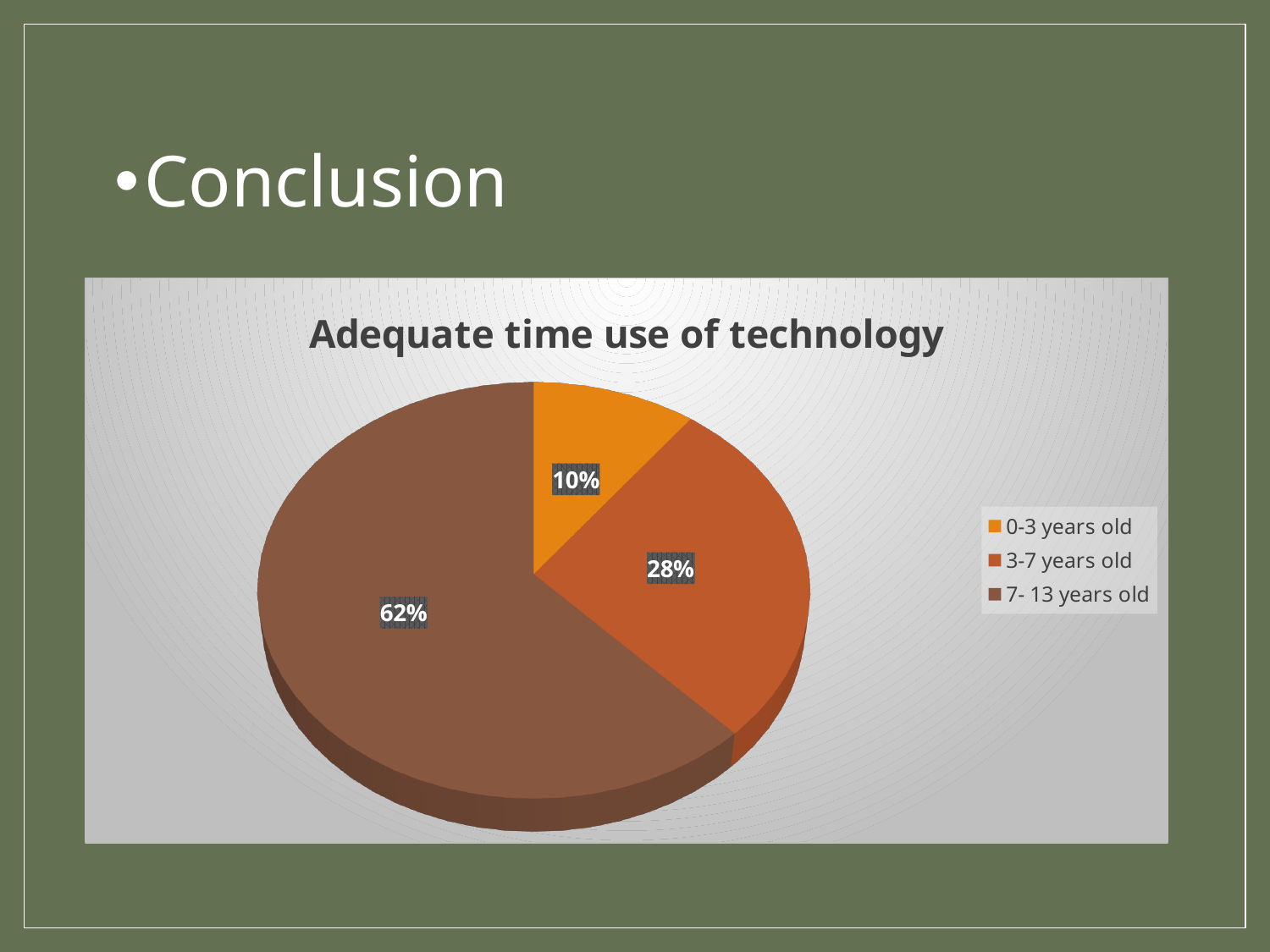
How many entries does the legend list? 3 What percentage is shown for 7- 13 years old? 62% What is the title of the chart? Adequate time use of technology Which is larger, the slice for 3-7 years old or the slice for 0-3 years old? 3-7 years old What is the difference in percentage points between the 7- 13 years old slice and the 3-7 years old slice? 34 Which age group has the smallest slice of the pie? 0-3 years old What percentage is shown for 0-3 years old? 10% What colour is the slice for 0-3 years old? orange Which age group has the largest slice of the pie? 7- 13 years old What kind of chart is shown on the slide? pie chart What percentage is shown for 3-7 years old? 28% How many slices does the pie chart have? 3